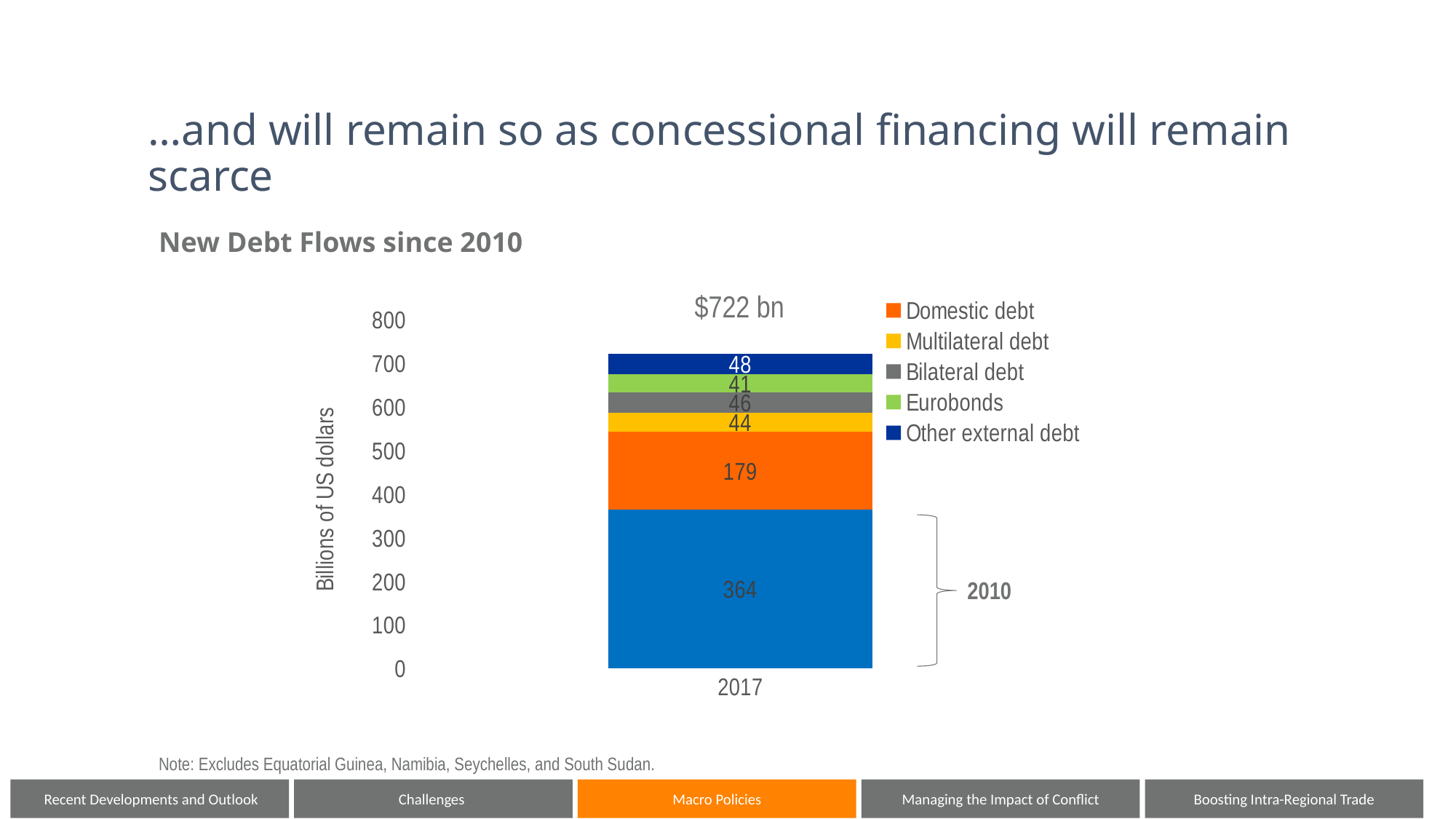
What kind of chart is shown on the slide? Stacked bar chart What is the value of the Multilateral debt segment in the 2017 bar? 44 What is the difference between the Domestic debt segment and the Multilateral debt segment? 135 What is the value of the Domestic debt segment in the 2017 bar? 179 What is the label on the vertical axis of the chart? Billions of US dollars How many series does the legend list? 5 Which is larger, the Bilateral debt segment or the Multilateral debt segment? Bilateral debt Which legend series has the largest segment in the 2017 bar? Domestic debt What is the value of the Eurobonds segment in the 2017 bar? 41 What is the total value of the 2017 stacked bar as labelled on the chart? $722 bn Which legend series has the smallest segment in the 2017 bar? Eurobonds What is the value of the Other external debt segment in the 2017 bar? 48